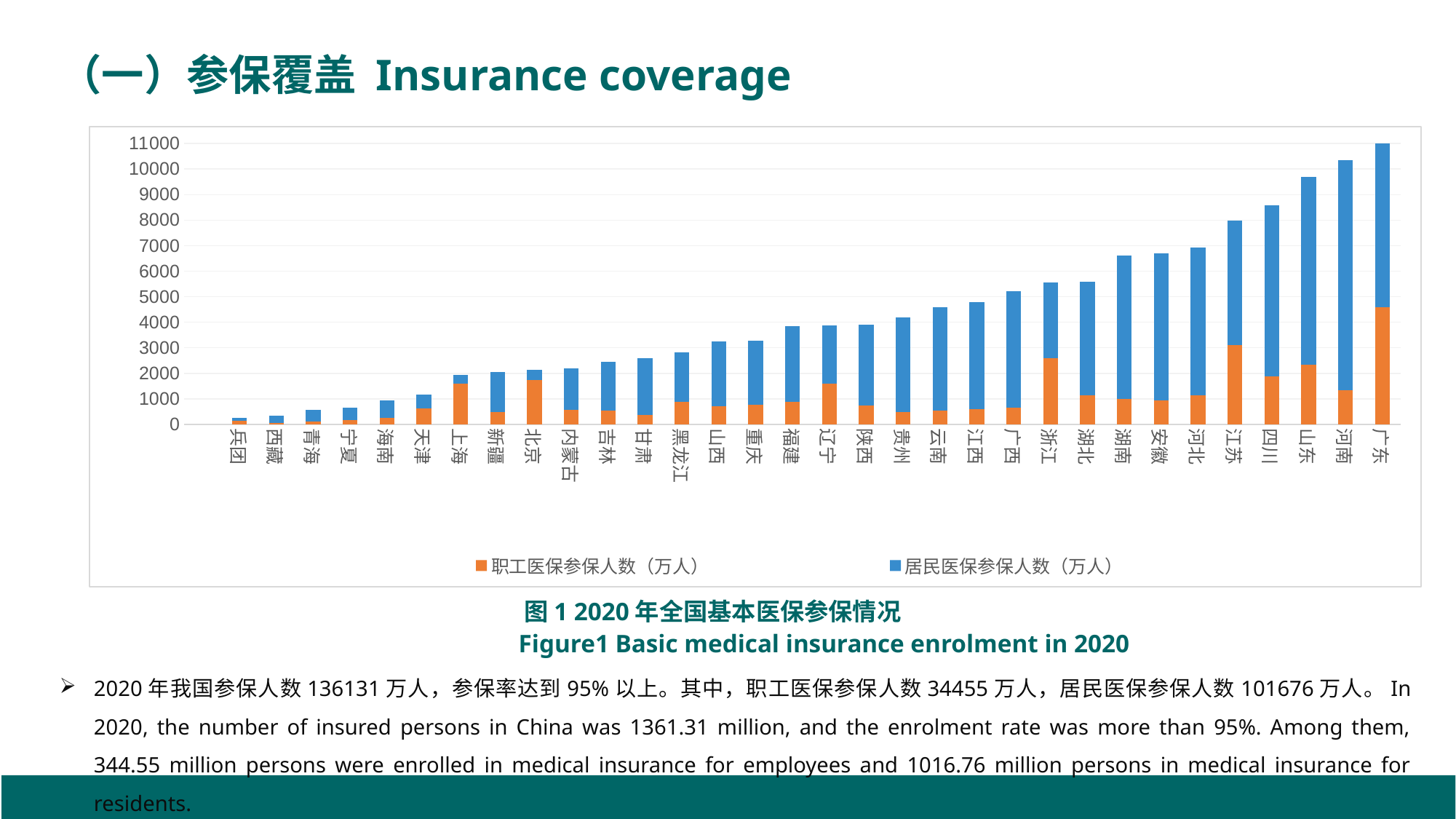
Which region has the highest total enrolment bar? 广东 Which colour represents 居民医保参保人数 in the legend? Blue Which region has the lowest total enrolment bar? 兵团 Do the total bar heights rise or fall from left to right along the x axis? Rise How many provinces/regions are shown on the x axis? 32 Is the 职工医保参保人数 (orange) value for 广东 greater or less than 4000? greater Which has the larger 职工医保参保人数 (orange) segment, 江苏 or 浙江? 江苏 How many series does the legend list? 2 Is the total bar for 广东 greater or less than 10000? greater What kind of chart is shown on the slide? Stacked bar chart Is the total bar for 山东 greater or less than 10000? less